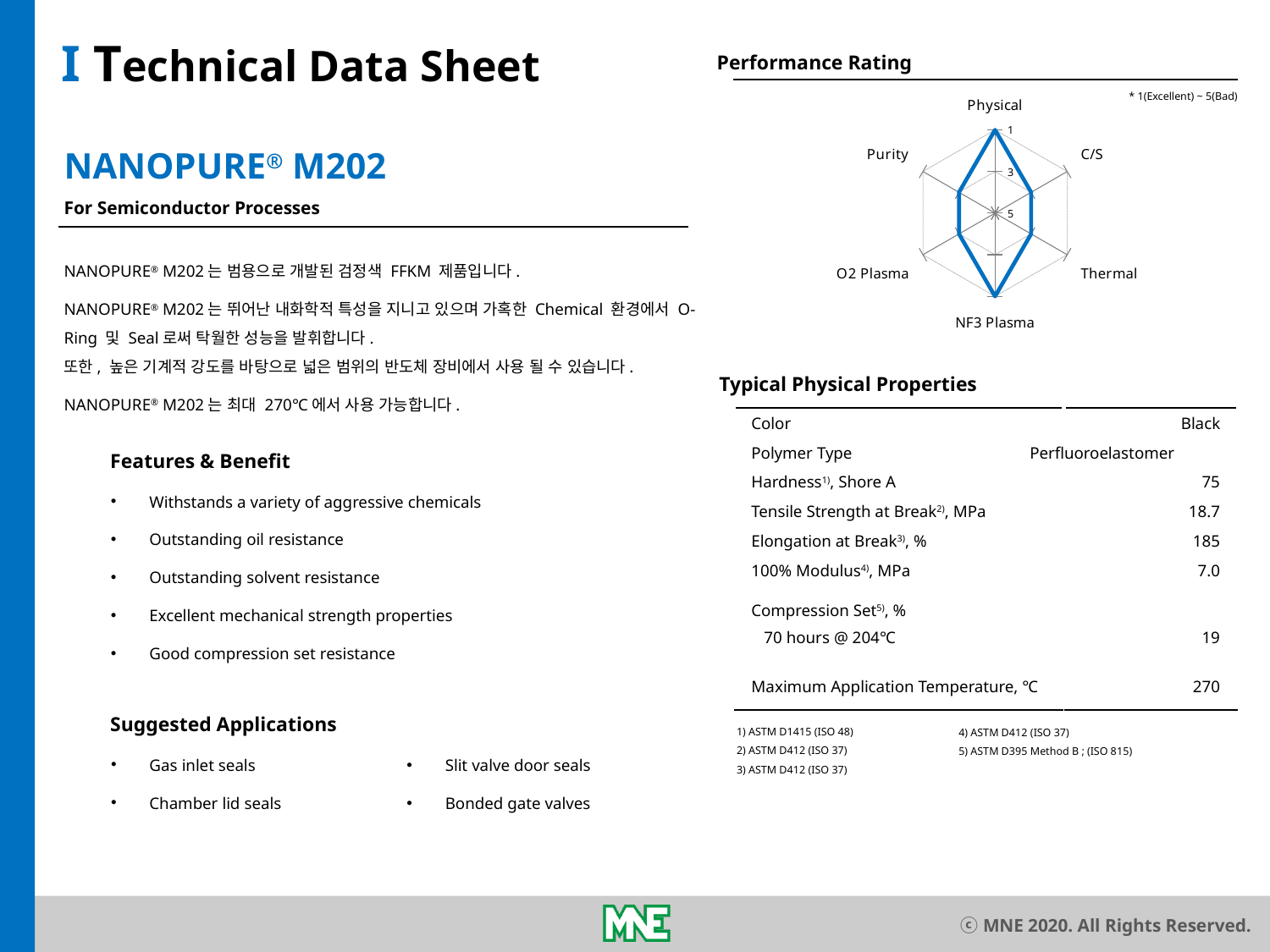
On the Performance Rating chart, which has the larger plotted value, Physical or C/S? C/S What is the plotted rating for Physical on the Performance Rating chart? 1 According to the note on the Performance Rating chart, what rating value means Excellent? 1 What is the title of the chart on the slide? Performance Rating How many categories (axes) does the Performance Rating radar chart have? 6 What kind of chart is shown under the heading "Performance Rating"? Radar chart Which category is labelled at the bottom of the Performance Rating radar chart? NF3 Plasma